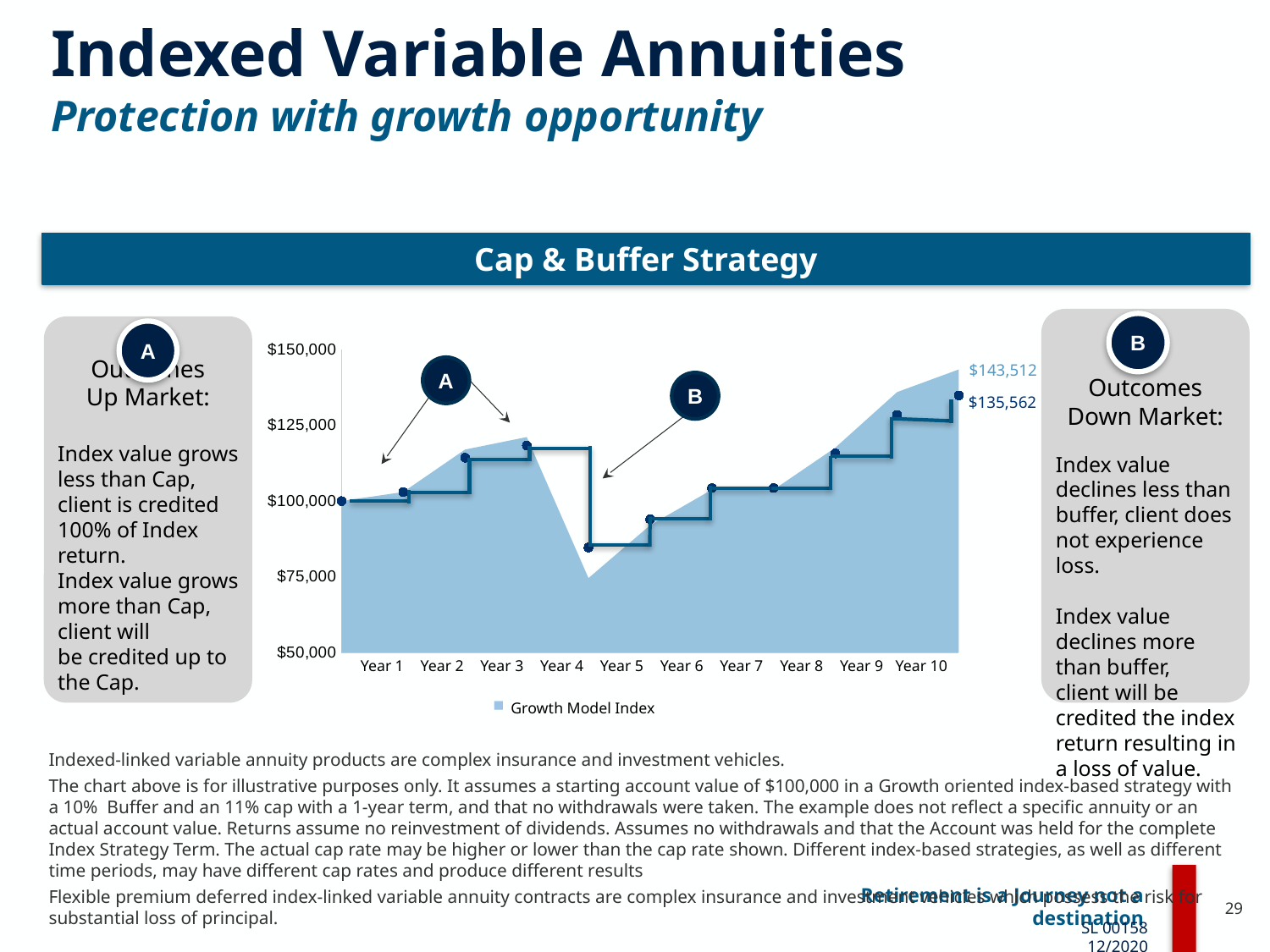
From Year 5 to Year 10, does the Growth Model Index rise or fall? rise How many series does the chart legend list? 1 What is the name of the series listed in the chart legend? Growth Model Index What is the difference between the two end values labelled on the chart, $143,512 and $135,562? $7,950 At the end of the chart, which is larger: the Growth Model Index value or the stepped account value? Growth Model Index ($143,512) What is the final value shown for the Growth Model Index at Year 10? $143,512 Is the Growth Model Index value at Year 3 greater or less than $100,000? greater What kind of chart is used to show the Growth Model Index? Area chart What is the final value shown for the stepped account value line at Year 10? $135,562 Is the lowest point of the Growth Model Index area greater or less than $100,000? less What is the title shown in the banner above the chart? Cap & Buffer Strategy How many years are labelled on the x axis of the chart? 10